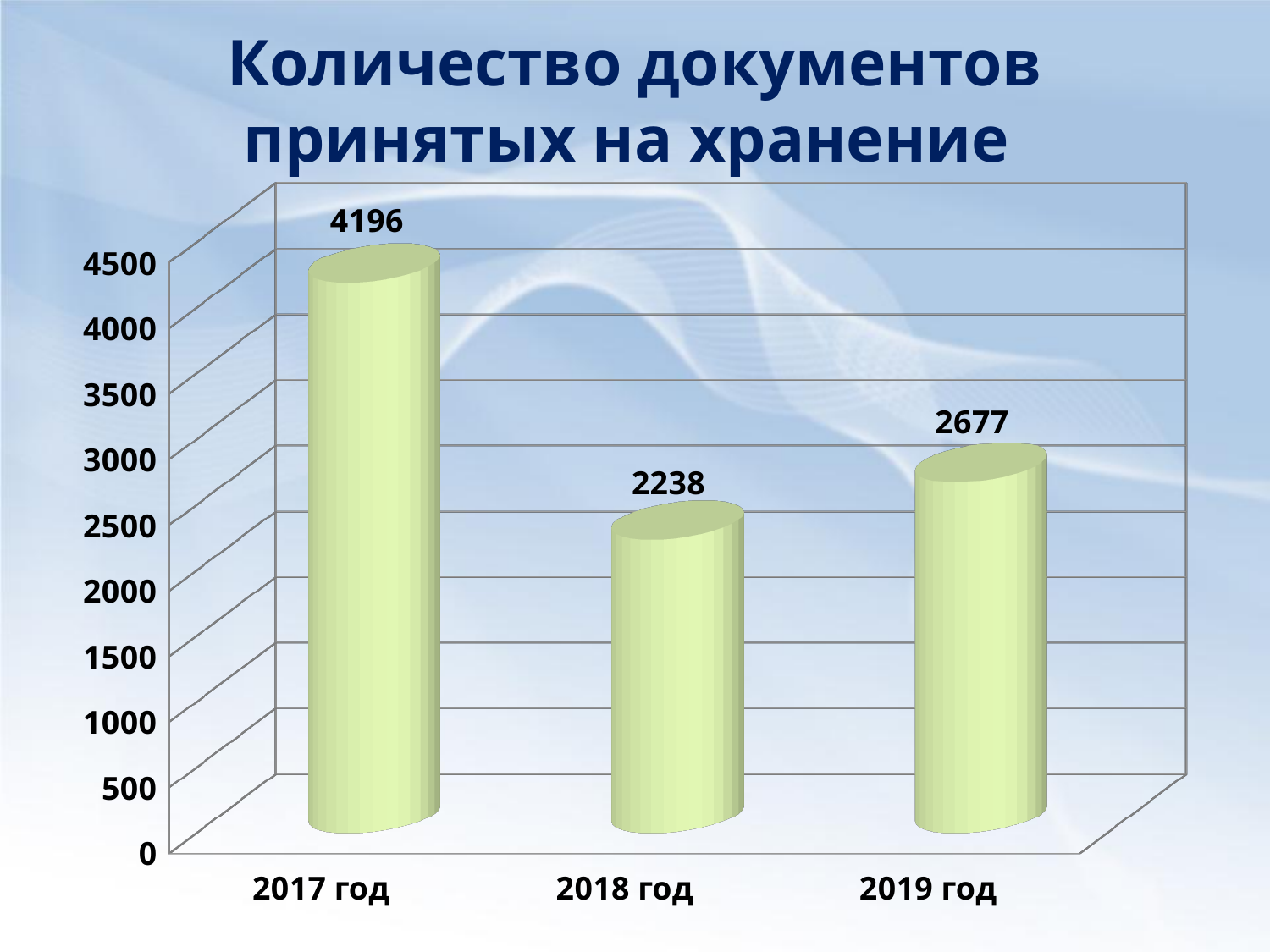
Which is larger, the value for 2018 год or 2019 год? 2019 год What is the title of the chart? Количество документов принятых на хранение What is the value for 2019 год? 2677 What is the value for 2018 год? 2238 What is the difference between the values for 2017 год and 2018 год? 1958 What is the value for 2017 год? 4196 Which year has the highest value? 2017 год Which year has the lowest value? 2018 год What kind of chart is shown on the slide? bar chart Is the value for 2017 год greater or less than 4000? greater What is the difference between the values for 2019 год and 2018 год? 439 How many categories are shown on the chart? 3